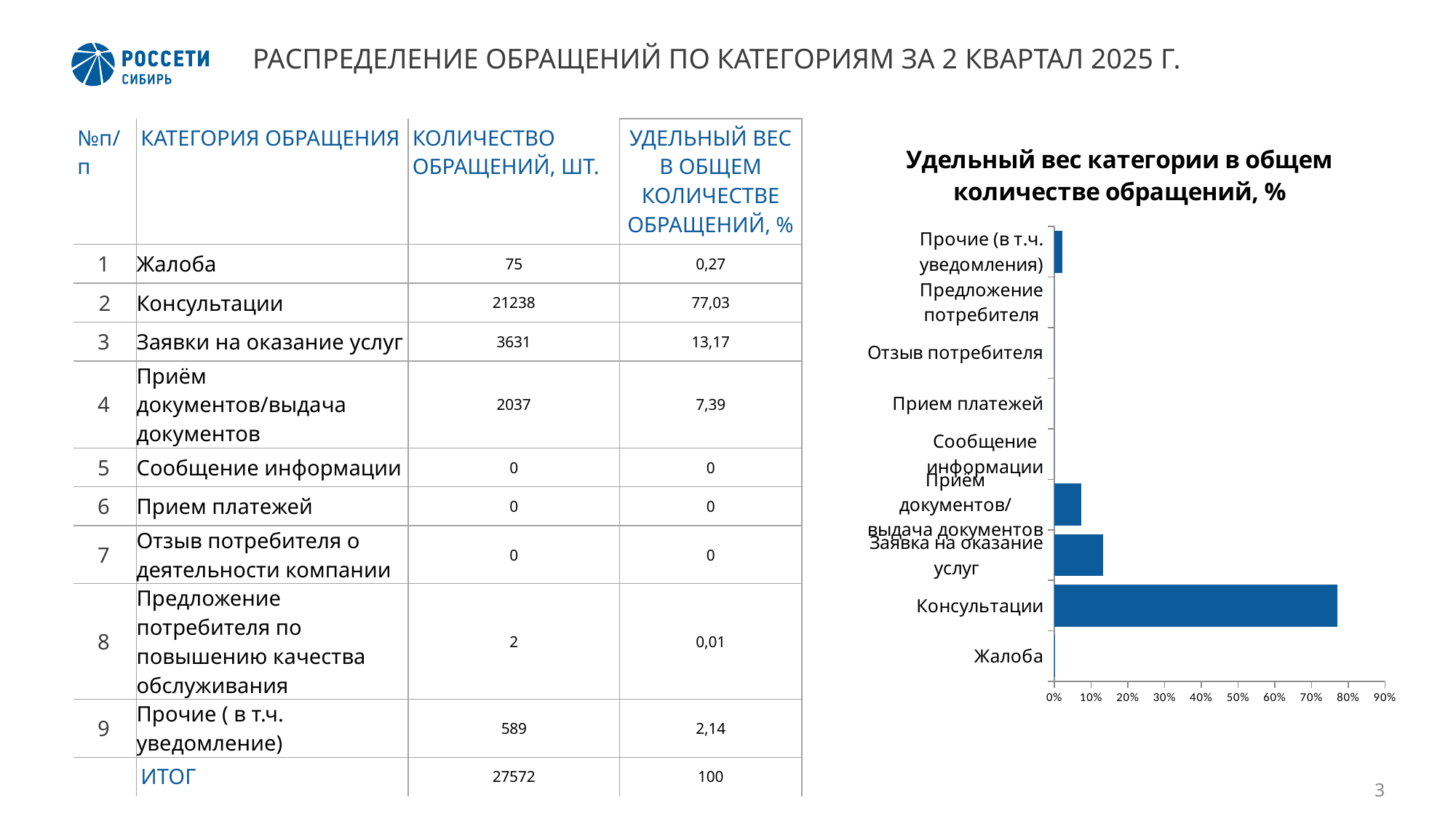
Which bar is longer in the chart: Заявка на оказание услуг or Приём документов/выдача документов? Заявка на оказание услуг How many categories are listed on the chart's vertical axis? 9 Which bar is longer in the chart: Консультации or Заявка на оказание услуг? Консультации What is the highest percentage tick shown on the chart's horizontal axis? 90% According to the slide's table, what is the share (удельный вес) of Заявки на оказание услуг plotted in the chart? 13,17 Which category has the longest bar in the chart? Консультации According to the slide's table, what is the share (удельный вес) of Консультации plotted in the chart? 77,03 What kind of chart is shown on the right of the slide? bar chart Is the value for Консультации in the chart greater or less than 70%? greater Is the value for Приём документов/выдача документов in the chart greater or less than 10%? less What is the title of the chart on the slide? Удельный вес категории в общем количестве обращений, % Is the value for Заявка на оказание услуг in the chart greater or less than 10%? greater